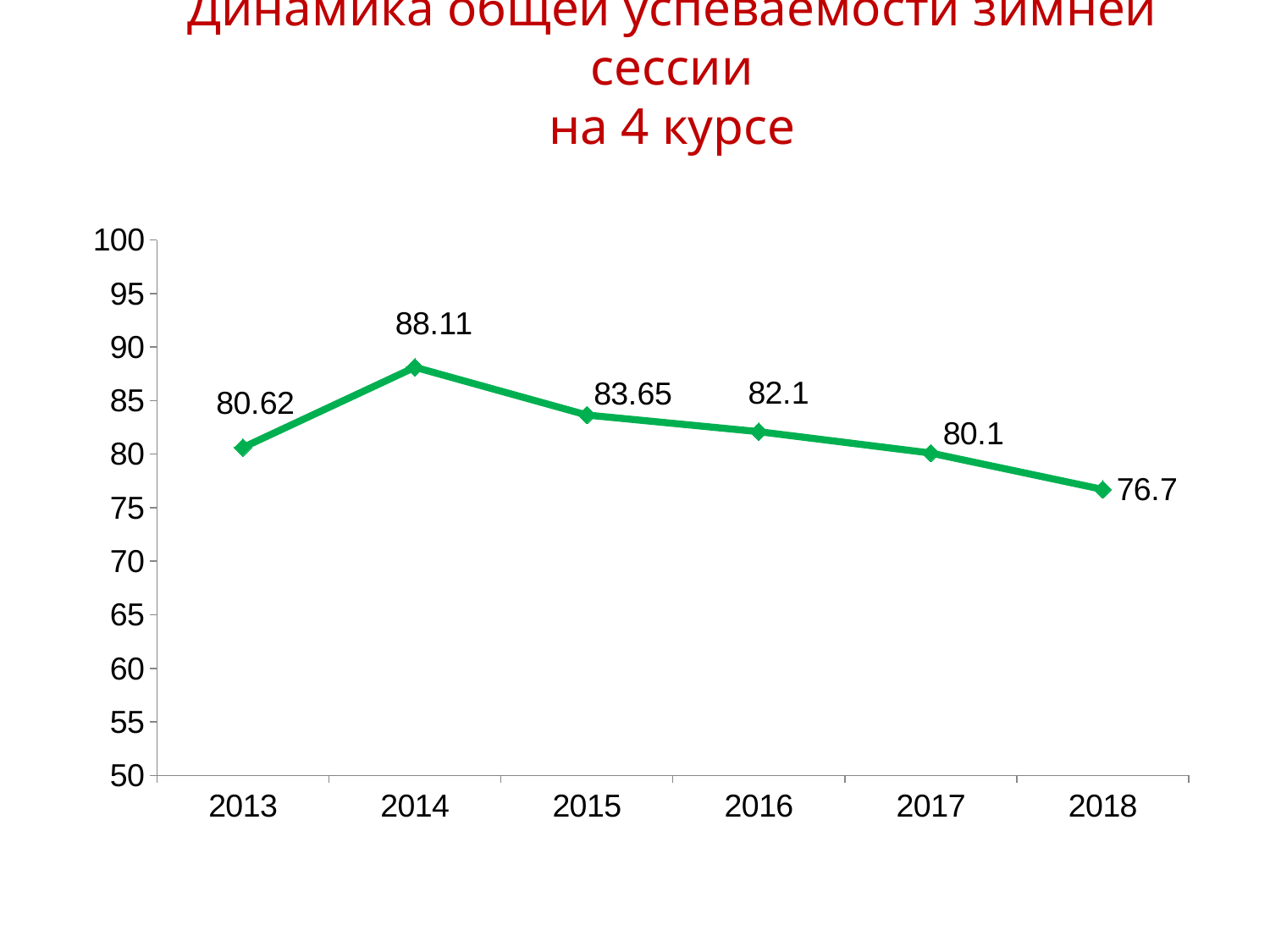
Which year has the lowest value? 2018 Do the values rise or fall from 2014 to 2018? fall Which year has the highest value? 2014 What is the value for 2014? 88.11 What is the difference between the values for 2014 and 2018? 11.41 What is the value for 2018? 76.7 What is the value for 2013? 80.62 What kind of chart is shown? line chart Which is larger, the value for 2015 or the value for 2016? 2015 What colour is the line on the chart? green Is the value for 2017 greater or less than 85? less How many years are plotted on the chart? 6